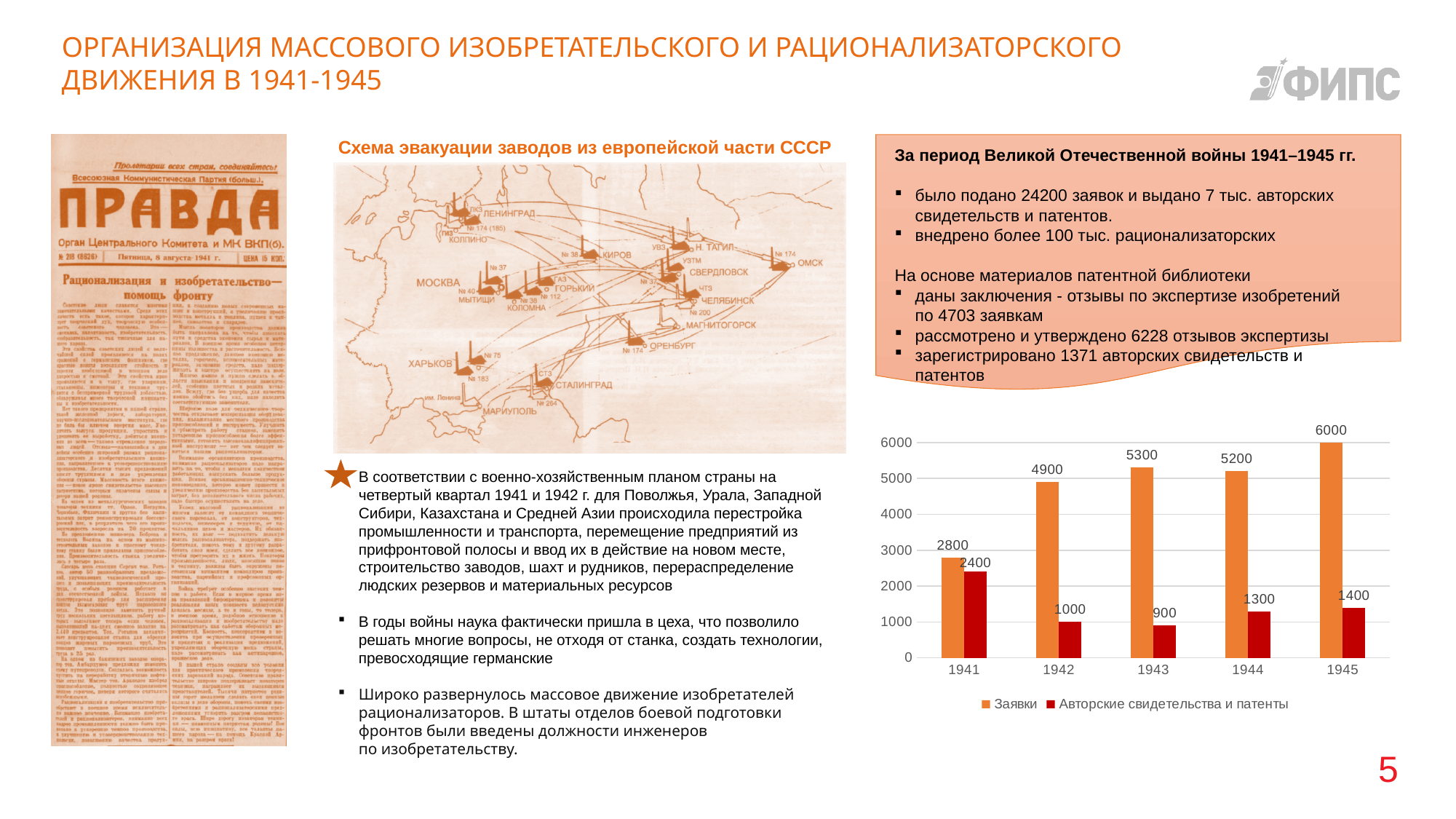
What kind of chart is shown on the slide? bar chart What is the value of Авторские свидетельства и патенты for 1944? 1300 What colour are the bars for Заявки in the chart? orange Which year has the lowest value for Авторские свидетельства и патенты? 1943 How many series does the chart legend list? 2 What is the difference between Заявки and Авторские свидетельства и патенты in 1945? 4600 Does the value of Авторские свидетельства и патенты rise or fall from 1941 to 1942? fall What is the value of Заявки for 1943? 5300 Which is larger: Заявки in 1942 or Заявки in 1944? Заявки in 1944 Is the value of Заявки for 1941 greater or less than 3000? less How many years are shown on the x axis of the chart? 5 Which year has the highest value for Заявки? 1945